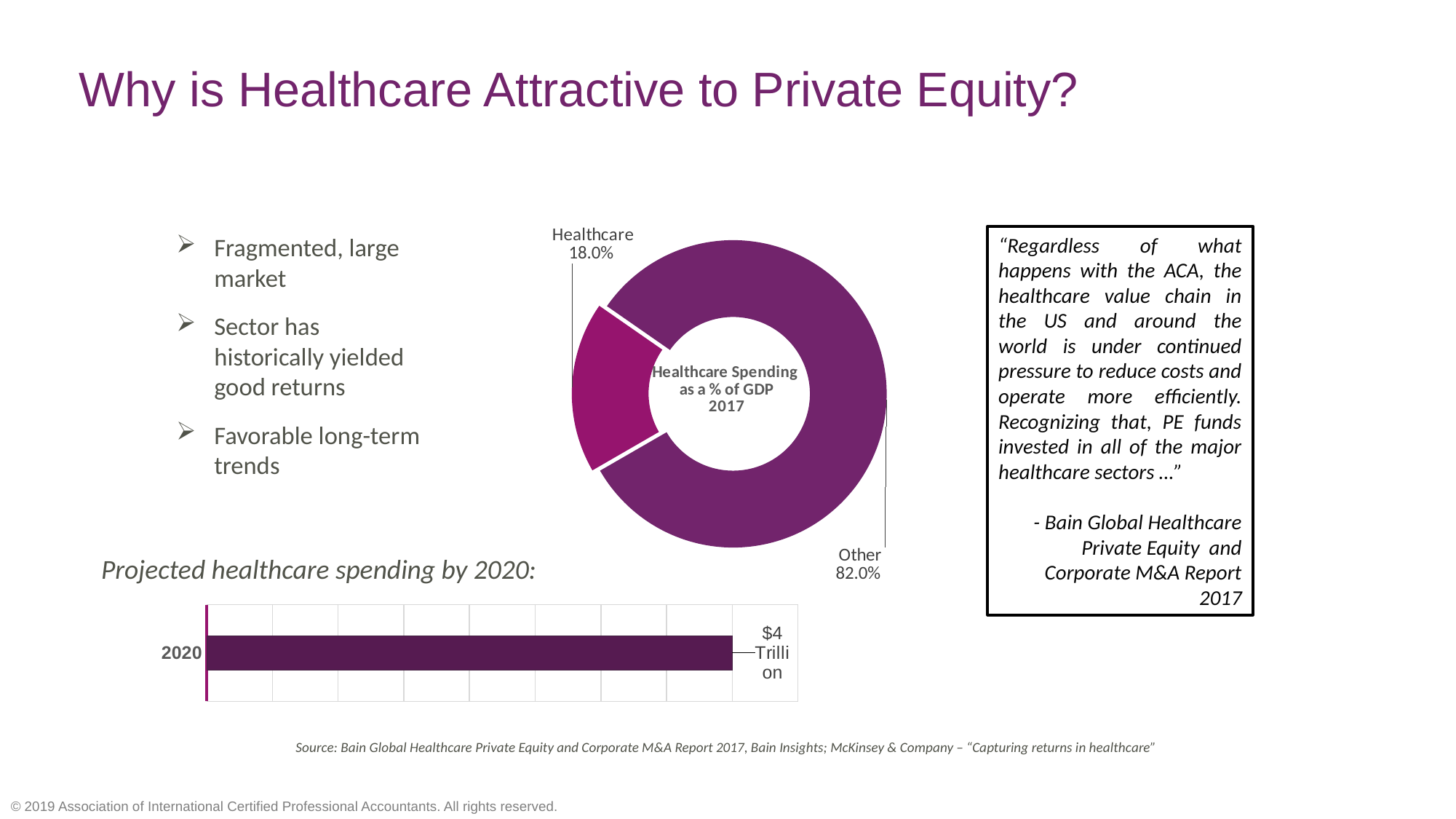
In the 'Projected healthcare spending by 2020' chart, how many bars are plotted? 1 In the 'Healthcare Spending as a % of GDP 2017' chart, how many slices are shown? 2 What kind of chart is the 'Projected healthcare spending by 2020' chart? Bar chart In the 'Healthcare Spending as a % of GDP 2017' chart, what share does Other have? 82.0% In the 'Projected healthcare spending by 2020' chart, what category label appears on the axis? 2020 What kind of chart is the 'Healthcare Spending as a % of GDP 2017' chart? Doughnut (pie) chart In the 'Healthcare Spending as a % of GDP 2017' chart, which slice is the largest? Other What is the title shown in the centre of the doughnut chart? Healthcare Spending as a % of GDP 2017 In the 'Healthcare Spending as a % of GDP 2017' chart, which slice is the smallest? Healthcare In the 'Healthcare Spending as a % of GDP 2017' chart, what is the difference in percentage points between Other and Healthcare? 64.0 percentage points In the 'Healthcare Spending as a % of GDP 2017' chart, what share does Healthcare have? 18.0% In the 'Projected healthcare spending by 2020' chart, what is the value shown for 2020? $4 Trillion